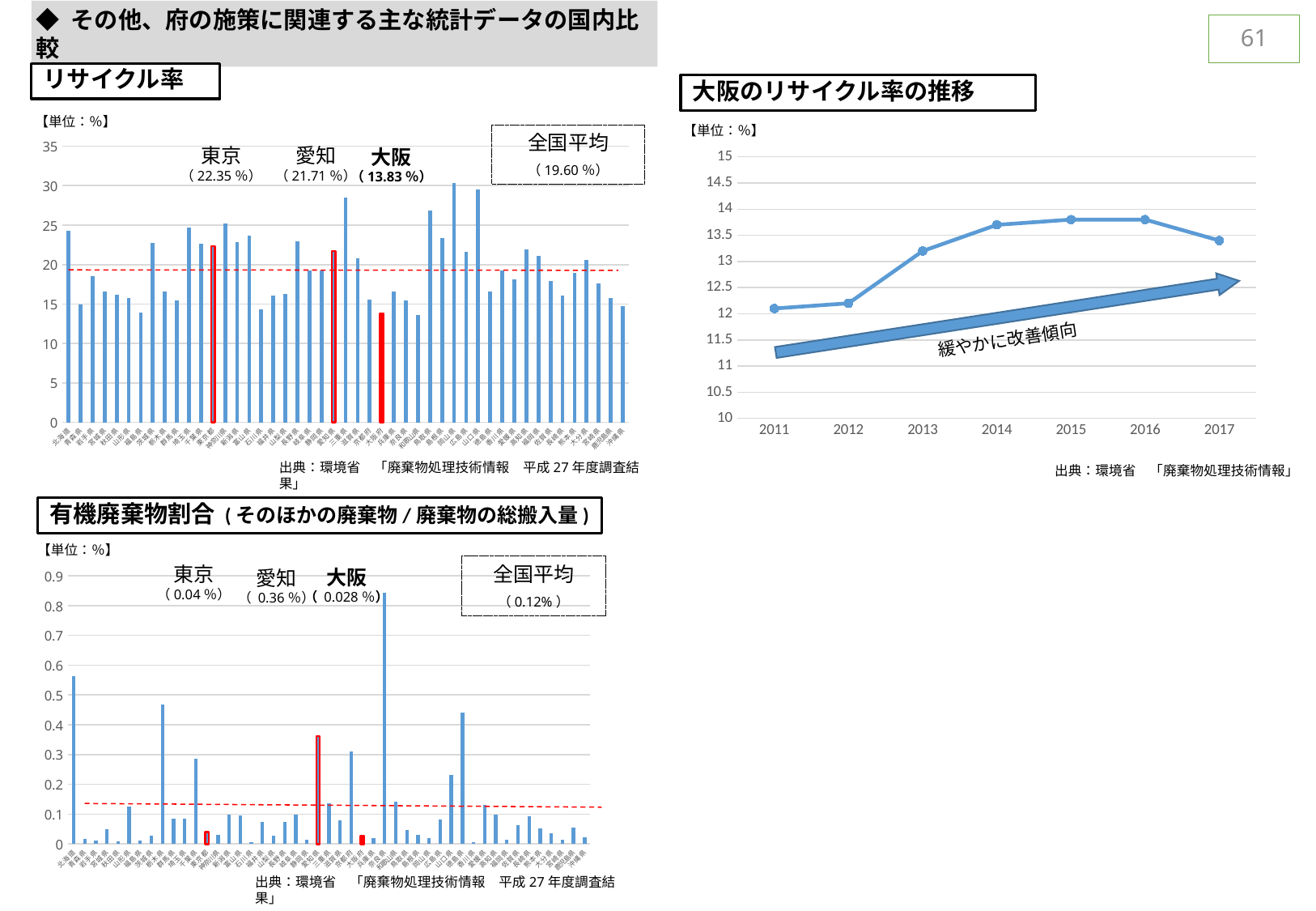
In the 大阪のリサイクル率の推移 chart, is the value for 2015 greater or less than 13.5? greater In the リサイクル率 chart, what is the difference between the values for 東京 and 大阪? 8.52 % What kind of chart is the リサイクル率 chart? bar chart In the リサイクル率 chart, what is the 全国平均 (national average) value shown? 19.60 % In the リサイクル率 chart, what is the recycling rate shown for 東京? 22.35 % In the 大阪のリサイクル率の推移 chart, is the value for 2011 greater or less than 12.5? less How many data points are plotted in the 大阪のリサイクル率の推移 chart? 7 In the リサイクル率 chart, which has the higher recycling rate, 東京 or 愛知? 東京 In the リサイクル率 chart, what is the recycling rate shown for 大阪? 13.83 % In the 有機廃棄物割合 chart, which of 東京, 愛知 and 大阪 has the highest value? 愛知 In the 有機廃棄物割合 chart, what is the value shown for 愛知? 0.36 % What kind of chart is the 大阪のリサイクル率の推移 chart? line chart